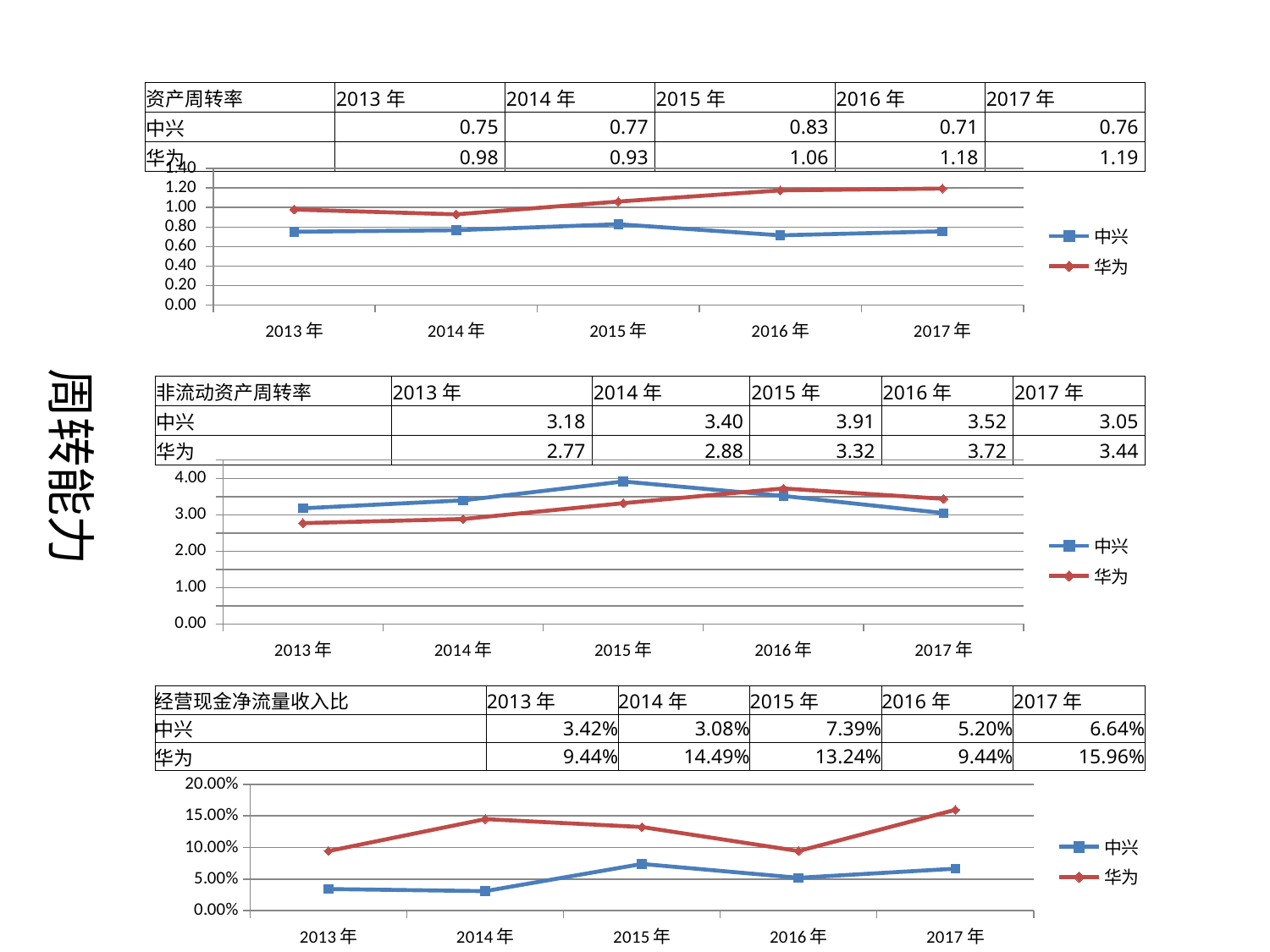
In the bottom chart (经营现金净流量收入比), what is the value for 华为 in 2014年? 14.49% In the top chart (资产周转率), what is the value for 华为 in 2017年? 1.19 What kind of chart is the middle chart (非流动资产周转率)? line chart In the bottom chart (经营现金净流量收入比), is the value for 中兴 in 2015年 greater or less than 5.00%? greater In the bottom chart (经营现金净流量收入比), which year has the highest value for 华为? 2017年 In the middle chart (非流动资产周转率), what is the value for 华为 in 2013年? 2.77 In the top chart (资产周转率), what is the value for 中兴 in 2015年? 0.83 In the middle chart (非流动资产周转率), which series has the larger value in 2016年, 中兴 or 华为? 华为 In the top chart (资产周转率), which year has the lowest value for 中兴? 2016年 In the middle chart (非流动资产周转率), which year has the highest value for 中兴? 2015年 In the top chart (资产周转率), what is the difference between 华为 and 中兴 in 2016年? 0.47 How many series does the legend of the bottom chart (经营现金净流量收入比) list? 2